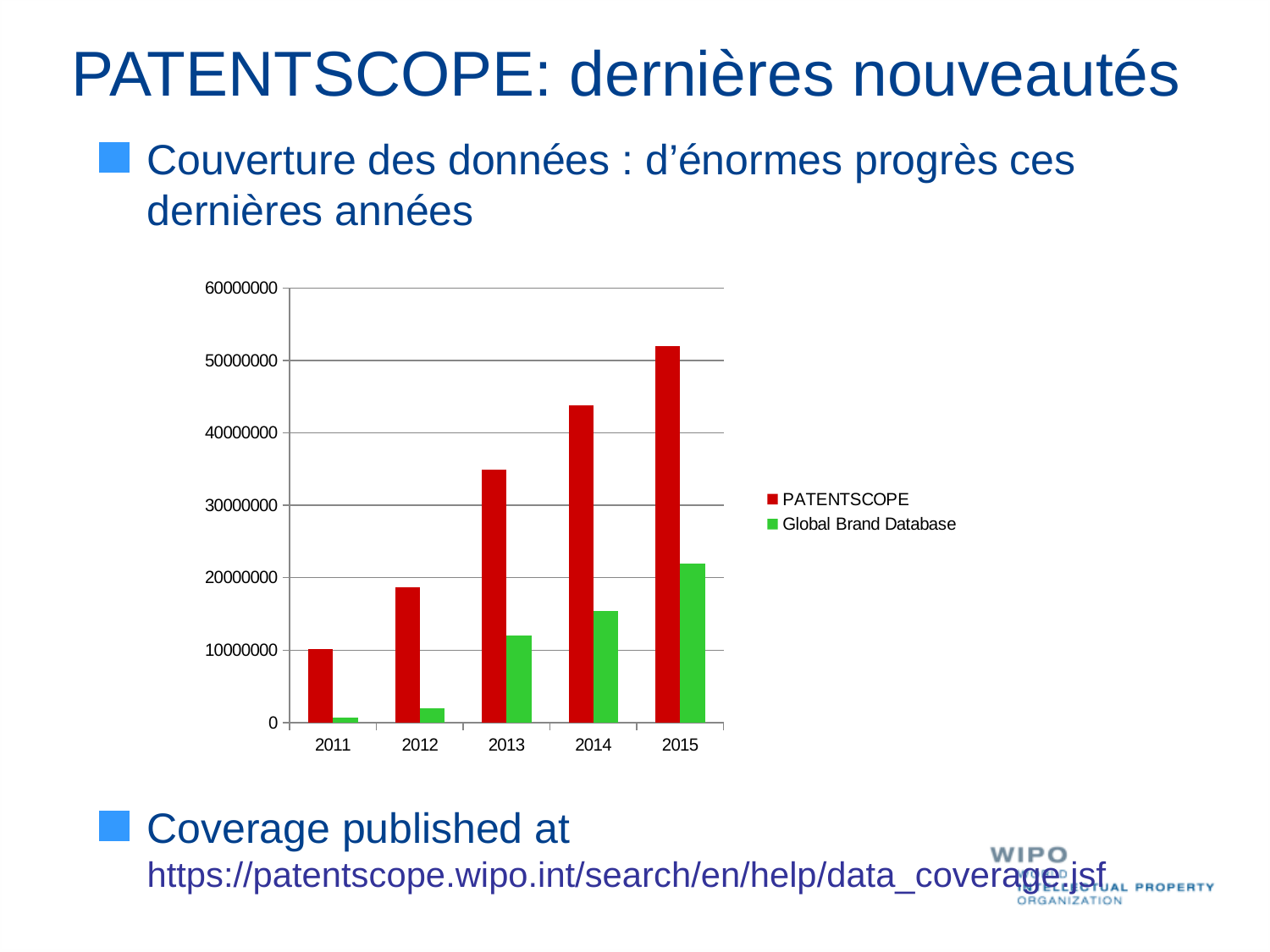
Is the PATENTSCOPE value for 2012 greater or less than 20000000? less Which year has the lowest Global Brand Database value? 2011 Do the PATENTSCOPE values rise or fall from 2011 to 2015? rise How many years are shown on the x axis of the chart? 5 In 2014, which series has the larger value, PATENTSCOPE or Global Brand Database? PATENTSCOPE Is the Global Brand Database value for 2015 greater or less than 20000000? greater Is the Global Brand Database value for 2013 greater or less than 10000000? greater How many series does the chart's legend list? 2 What kind of chart is shown on the slide? bar chart Which colour represents the Global Brand Database series in the chart? green Which year has the highest PATENTSCOPE value? 2015